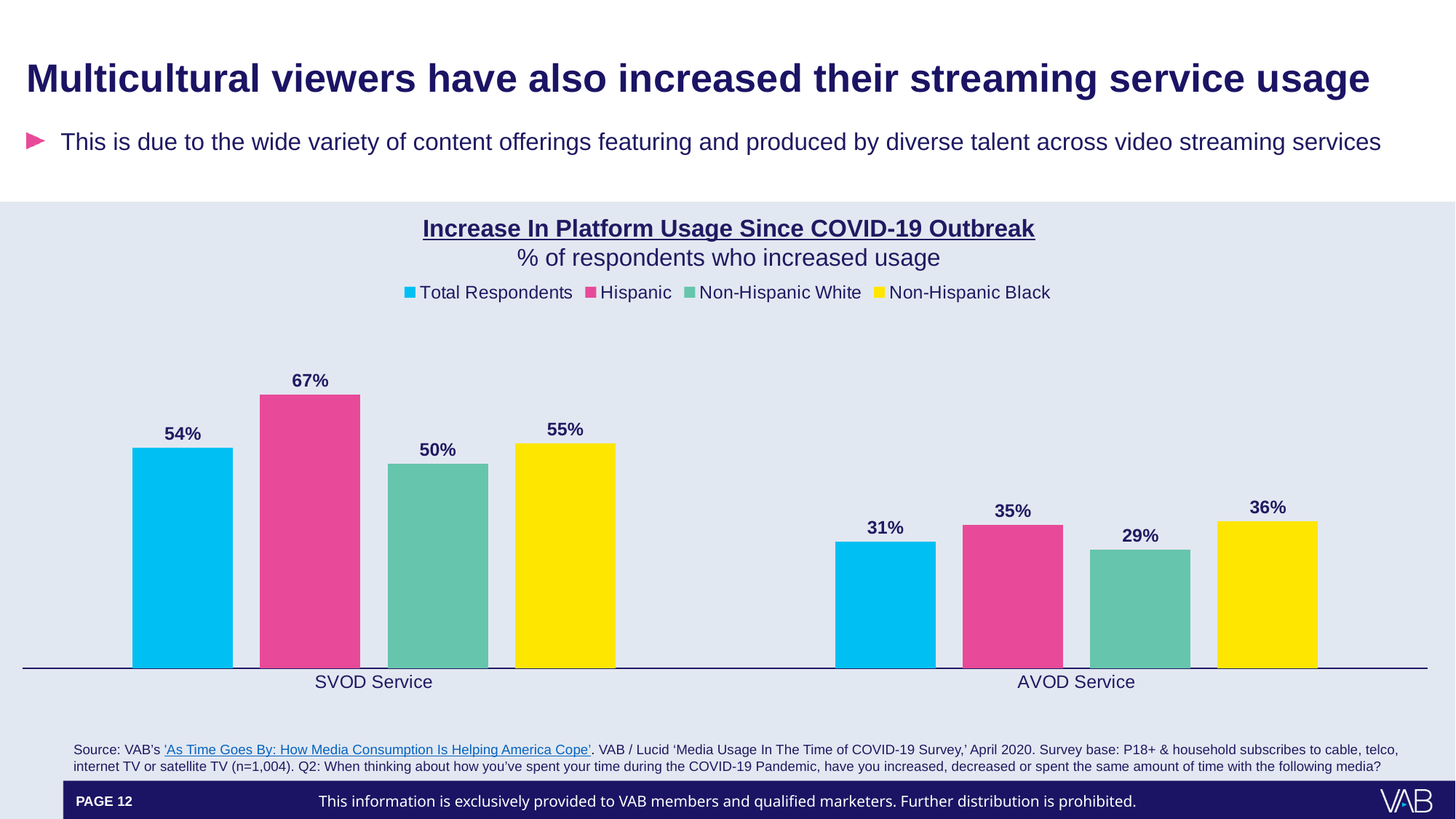
Which is larger for AVOD Service: the Hispanic value or the Non-Hispanic Black value? Non-Hispanic Black What percentage of Hispanic respondents increased their SVOD Service usage? 67% What is the title of the chart? Increase In Platform Usage Since COVID-19 Outbreak What is the value for Total Respondents for AVOD Service? 31% How many categories are shown on the x axis? 2 What is the difference between the Hispanic and Non-Hispanic White values for SVOD Service? 17% What is the difference between the Non-Hispanic Black values for SVOD Service and AVOD Service? 19% What kind of chart is shown on the slide? Bar chart How many series does the legend list? 4 Which group has the highest value for SVOD Service? Hispanic What is the value for Non-Hispanic White respondents for AVOD Service? 29% Which group has the lowest value for AVOD Service? Non-Hispanic White